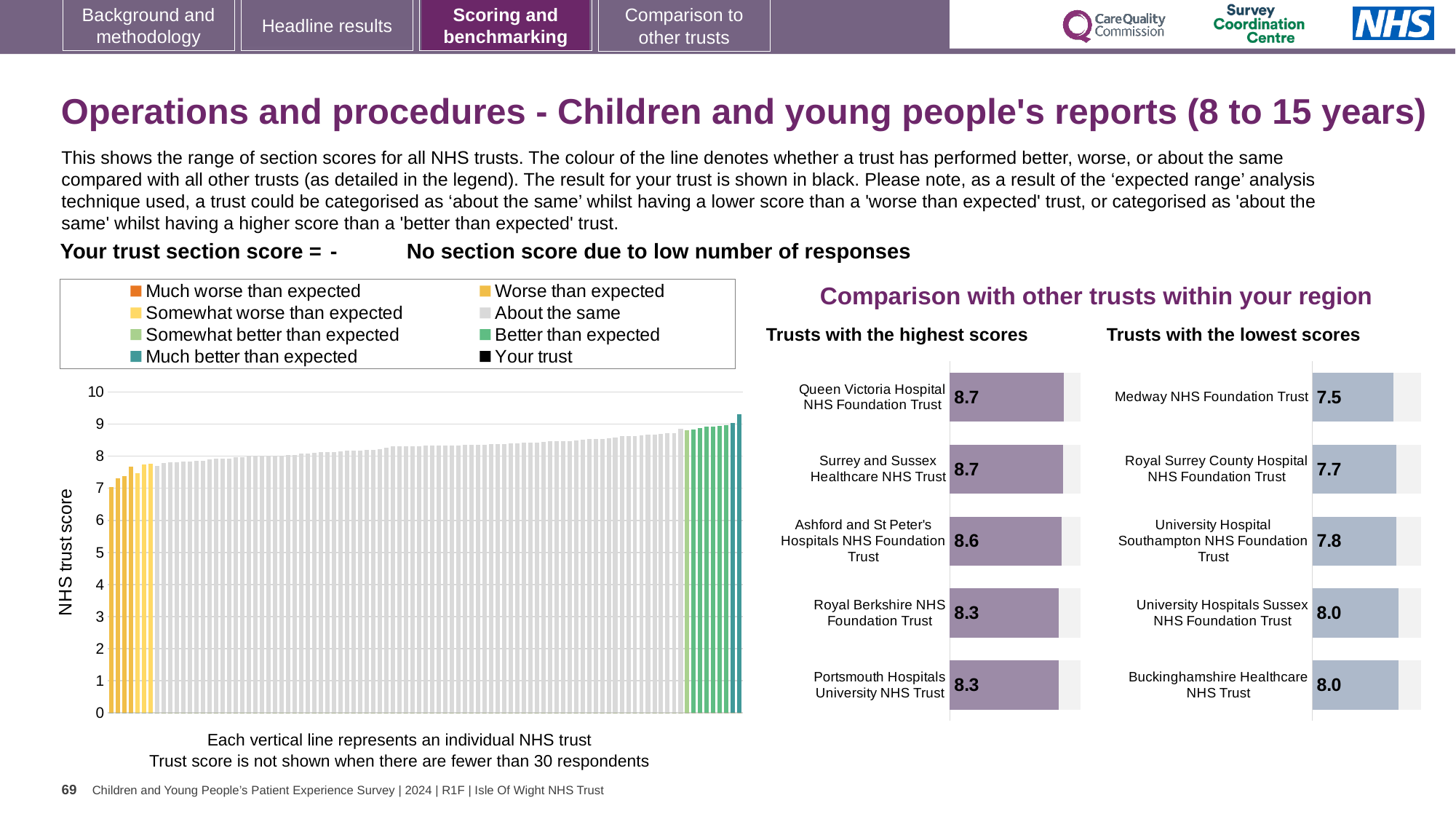
In the 'Trusts with the highest scores' chart, what is the difference between the scores of Queen Victoria Hospital NHS Foundation Trust and Royal Berkshire NHS Foundation Trust? 0.4 In the 'Trusts with the highest scores' chart, what is the score for Ashford and St Peter's Hospitals NHS Foundation Trust? 8.6 In the 'Trusts with the highest scores' chart, what is the score for Queen Victoria Hospital NHS Foundation Trust? 8.7 In the large 'NHS trust score' chart on the left, is the value of the lowest bar greater or less than 6? greater How many entries does the legend above the large 'NHS trust score' chart list? 8 In the 'Trusts with the lowest scores' chart, what is the score for Medway NHS Foundation Trust? 7.5 In the 'Trusts with the lowest scores' chart, what is the difference between the scores of Buckinghamshire Healthcare NHS Trust and Medway NHS Foundation Trust? 0.5 In the 'Trusts with the lowest scores' chart, which trust has the lowest score? Medway NHS Foundation Trust In the 'Trusts with the highest scores' chart, which has the higher score: Ashford and St Peter's Hospitals NHS Foundation Trust or Portsmouth Hospitals University NHS Trust? Ashford and St Peter's Hospitals NHS Foundation Trust In the large 'NHS trust score' chart on the left, do the bar values rise or fall from left to right? rise In the 'Trusts with the lowest scores' chart, what is the score for University Hospital Southampton NHS Foundation Trust? 7.8 How many trusts are listed in the 'Trusts with the lowest scores' chart? 5